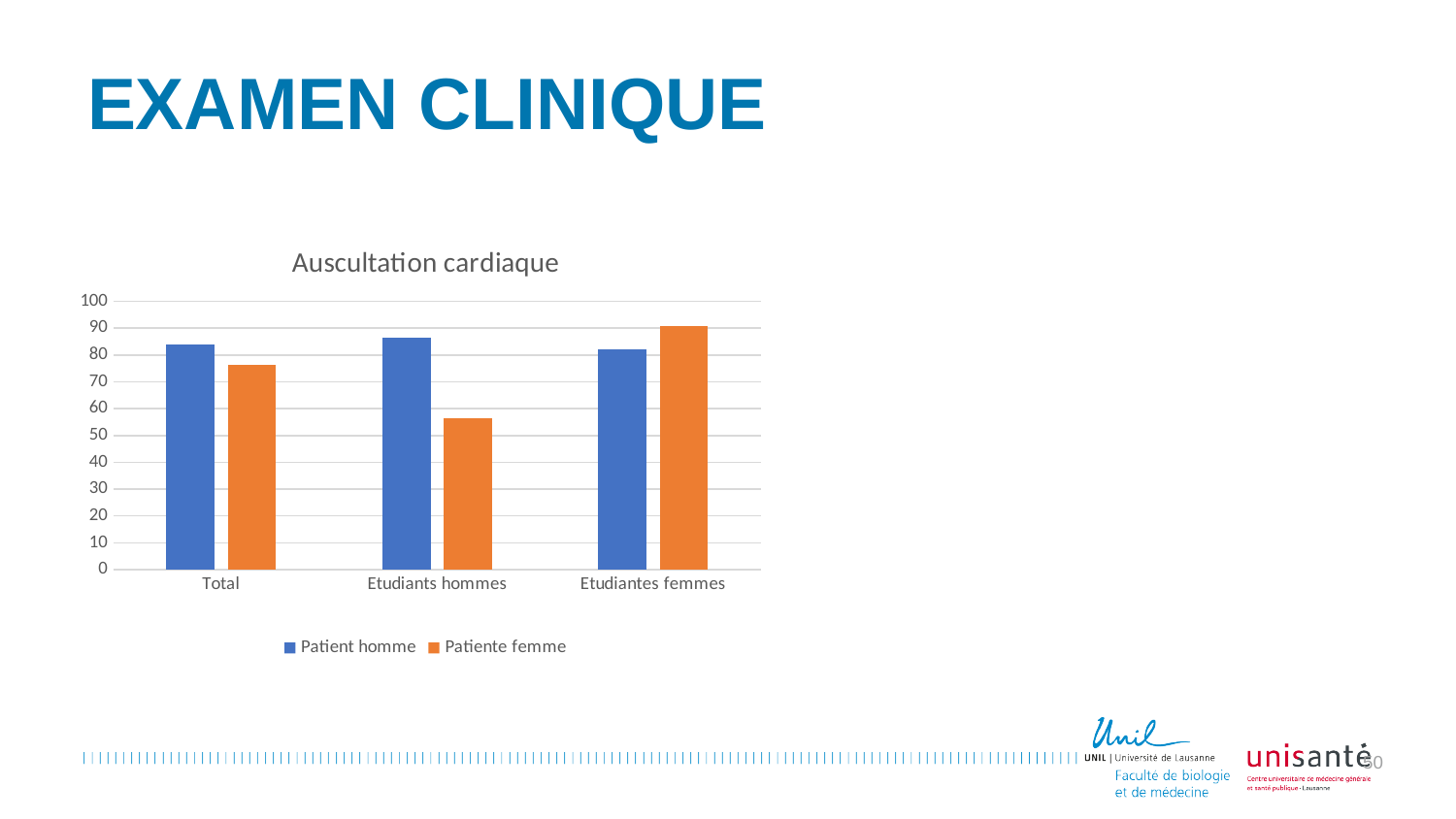
Is the value for Patiente femme in the Etudiants hommes category greater or less than 60? less How many categories are shown on the x axis? 3 Is the value for Patient homme in the Etudiants hommes category greater or less than 80? greater Which colour represents the Patiente femme series? orange In the Etudiantes femmes category, which is larger: Patient homme or Patiente femme? Patiente femme What type of chart is shown on the slide? bar chart For the Patiente femme series, which category has the lowest value? Etudiants hommes In the Etudiants hommes category, which is larger: Patient homme or Patiente femme? Patient homme How many series does the legend list? 2 Is the value for Patiente femme in the Etudiantes femmes category greater or less than 80? greater What is the title of the chart? Auscultation cardiaque